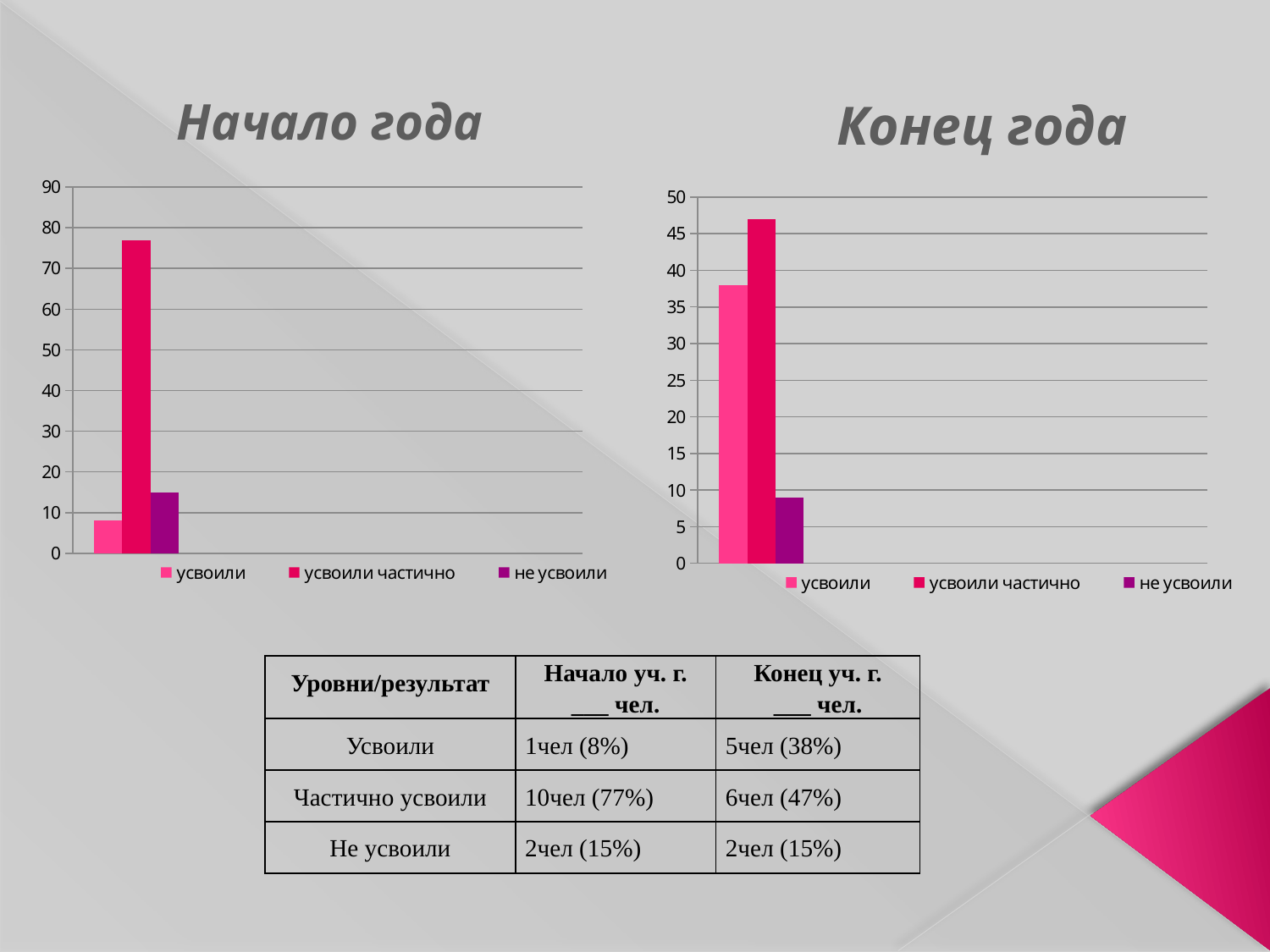
In the "Конец года" chart, is the value for "усвоили" greater or less than 35? greater In the "Начало года" chart, which series has the highest bar? усвоили частично In the "Конец года" chart, which series has the lowest bar? не усвоили In the "Начало года" chart, is the value for "усвоили частично" greater or less than 70? greater What kind of chart is the "Начало года" chart? bar chart In the "Начало года" chart, is the value for "усвоили" greater or less than 10? less What is the title of the chart on the right side of the slide? Конец года In the "Начало года" chart, which series has the lowest bar? усвоили In the "Конец года" chart, which is larger, the bar for "усвоили" or the bar for "не усвоили"? усвоили In the "Конец года" chart, which series has the highest bar? усвоили частично How many series does the legend of the "Конец года" chart list? 3